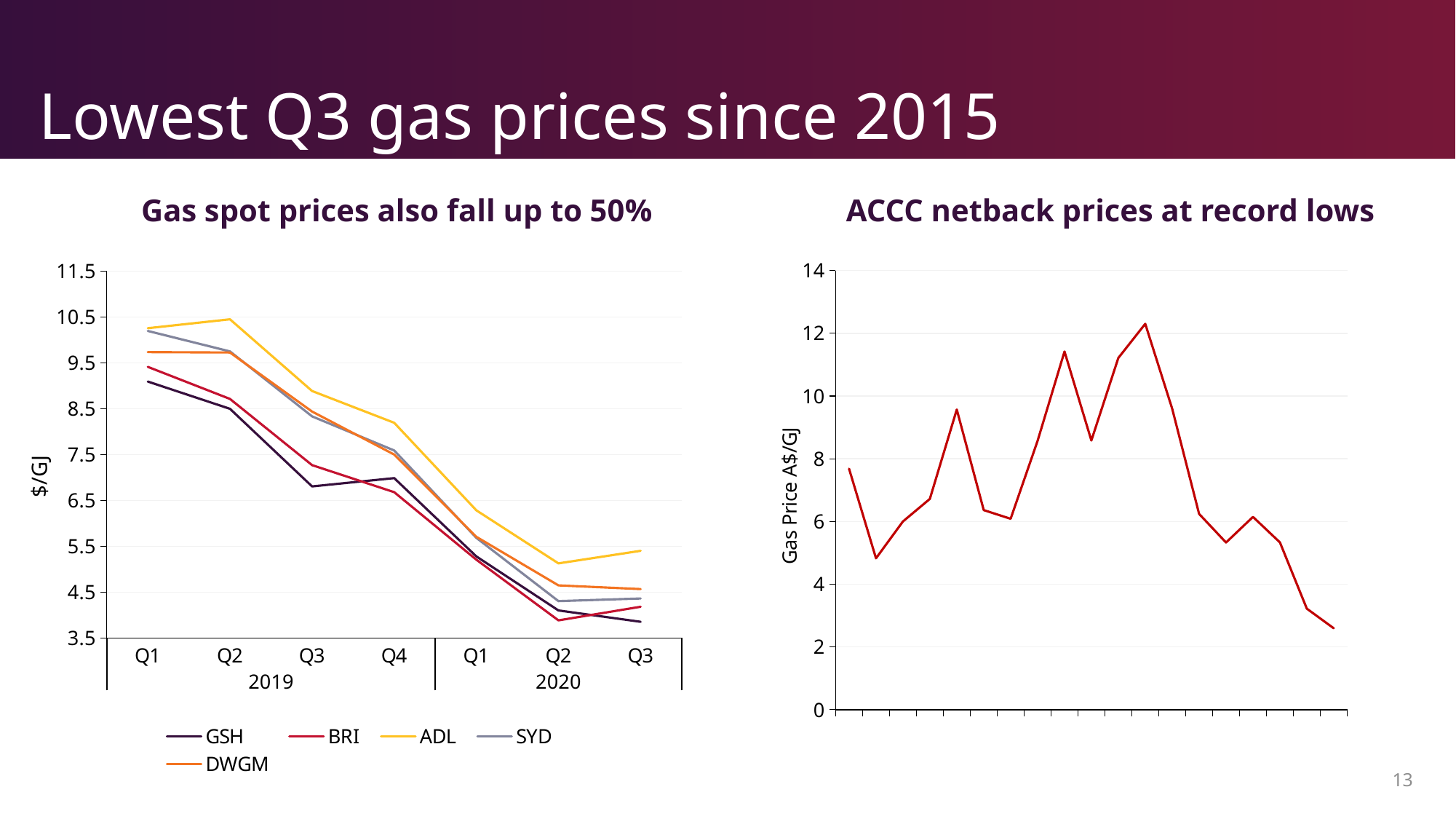
How many series does the legend of the 'Gas spot prices also fall up to 50%' chart list? 5 In the 'Gas spot prices also fall up to 50%' chart, which is larger in Q3 2020: ADL or BRI? ADL In the 'ACCC netback prices at record lows' chart, is the final point on the line greater or less than 4? less In the 'Gas spot prices also fall up to 50%' chart, do the series generally rise or fall from Q1 2019 to Q3 2020? fall In the 'Gas spot prices also fall up to 50%' chart, is the GSH value for Q3 2019 greater or less than 7.5? less In the 'Gas spot prices also fall up to 50%' chart, is the ADL value for Q2 2019 greater or less than 9.5? greater In the 'Gas spot prices also fall up to 50%' chart, which series has the highest value in Q2 2019? ADL What kind of chart is the 'Gas spot prices also fall up to 50%' chart? line chart In the 'Gas spot prices also fall up to 50%' chart, which series has the lowest value in Q3 2020? GSH What is the y-axis label of the 'ACCC netback prices at record lows' chart? Gas Price A$/GJ How many quarters are plotted along the x axis of the 'Gas spot prices also fall up to 50%' chart? 7